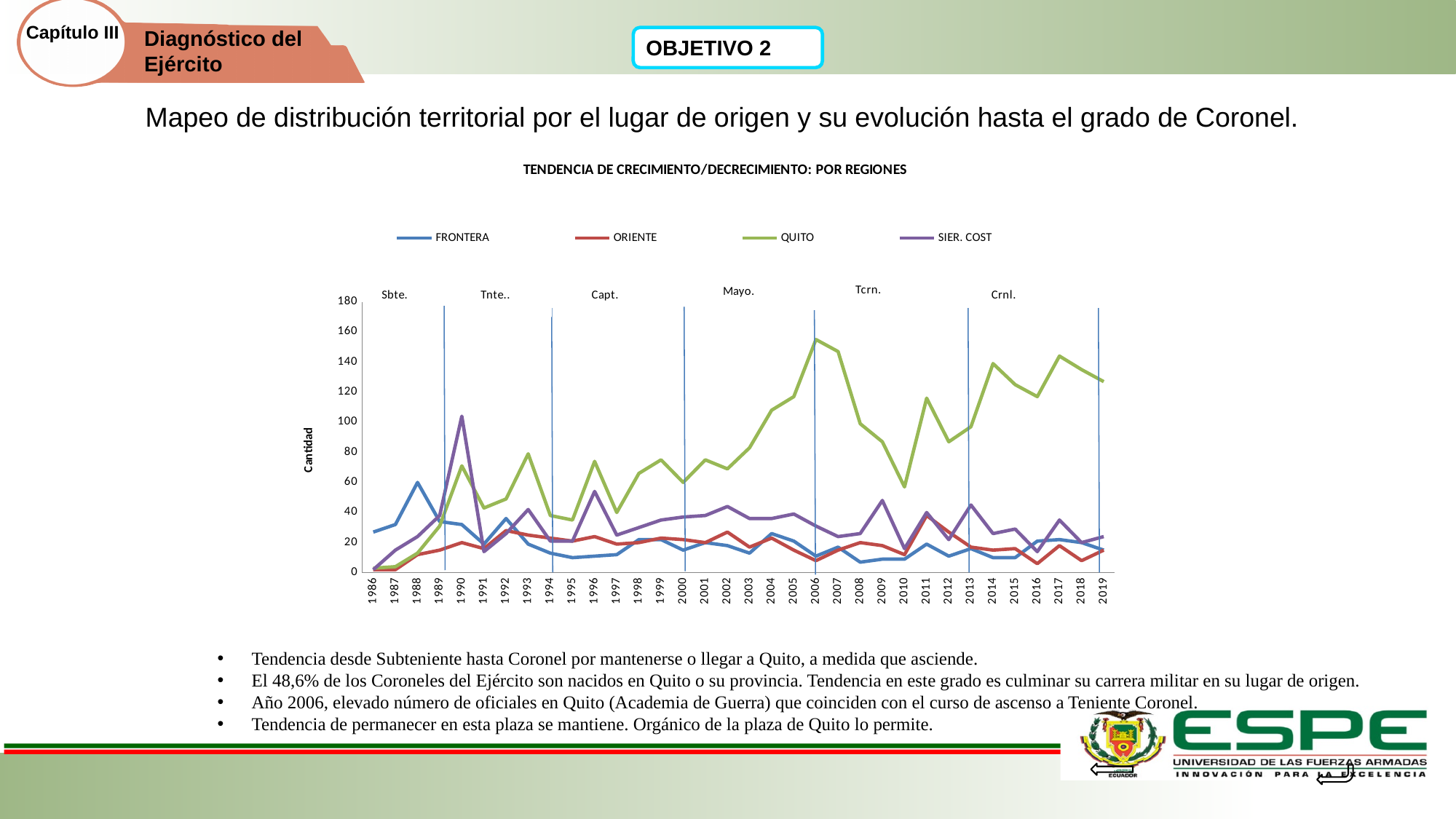
How many series does the legend list? 4 Which series has the highest value in 1990? SIER. COST Is the value for QUITO in 2010 greater or less than 80? less Is the value for QUITO in 2006 greater or less than 140? greater What is the title of the chart? TENDENCIA DE CRECIMIENTO/DECRECIMIENTO: POR REGIONES What kind of chart is shown on the slide? line chart How many years are plotted along the x axis? 34 Which series reaches the highest value anywhere on the chart? QUITO Is the value for FRONTERA in 1988 greater or less than 40? greater Does the QUITO line rise or fall between 2000 and 2006? rise Which series has the higher value in 2019, QUITO or ORIENTE? QUITO